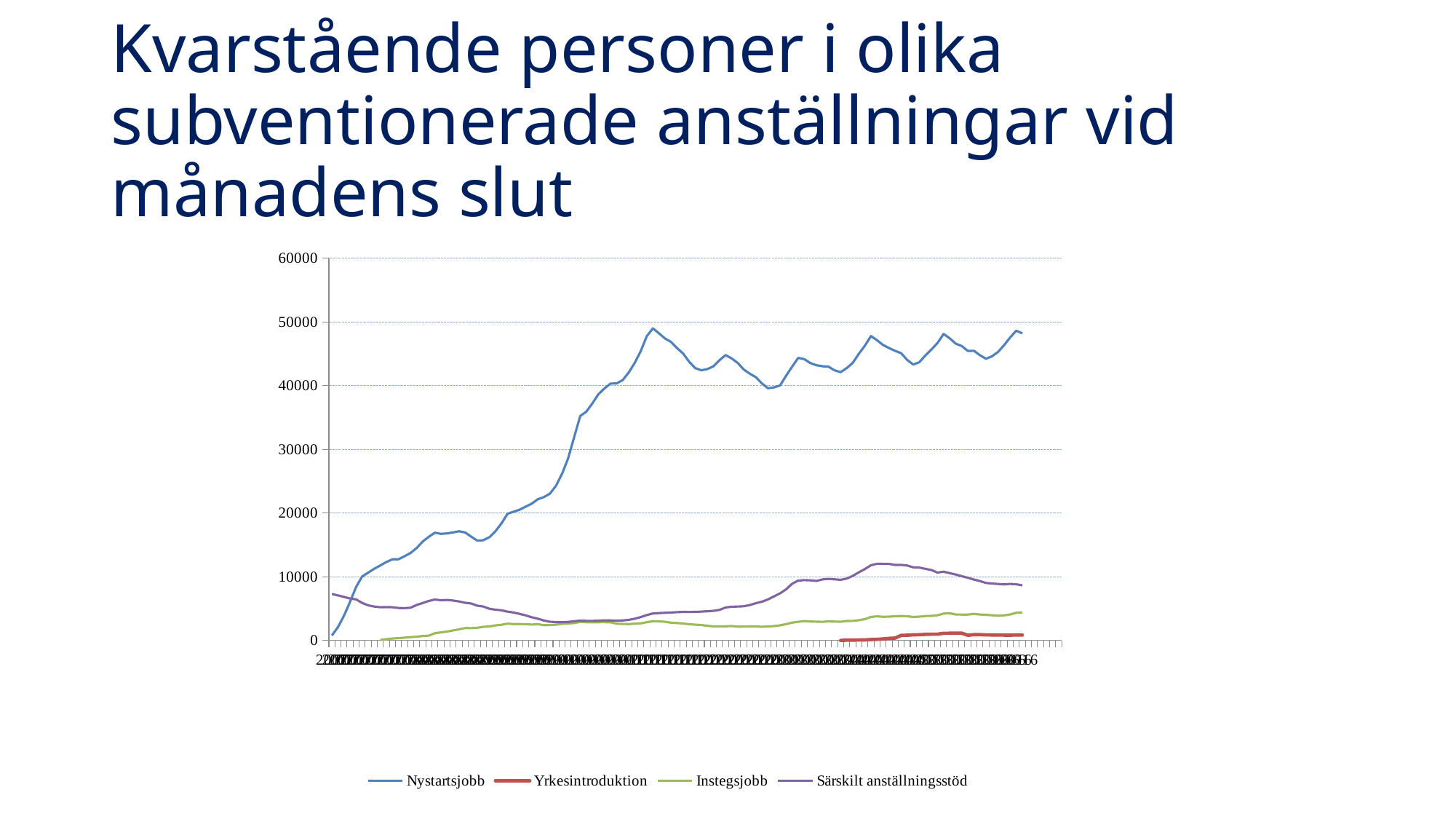
Which series stays lowest throughout the chart? Yrkesintroduktion What kind of chart is shown on the slide? line chart Is the peak value of the Särskilt anställningsstöd line greater or less than 10000? greater What is the highest value shown on the vertical axis? 60000 Is the highest value of the Yrkesintroduktion line greater or less than 10000? less Is the peak value of the Nystartsjobb line greater or less than 40000? greater Which series reaches higher values, Instegsjobb or Yrkesintroduktion? Instegsjobb Which series reaches the highest values in the chart? Nystartsjobb What is the title of the slide? Kvarstående personer i olika subventionerade anställningar vid månadens slut Does the Nystartsjobb line overall rise or fall from left to right? rise How many series does the legend list? 4